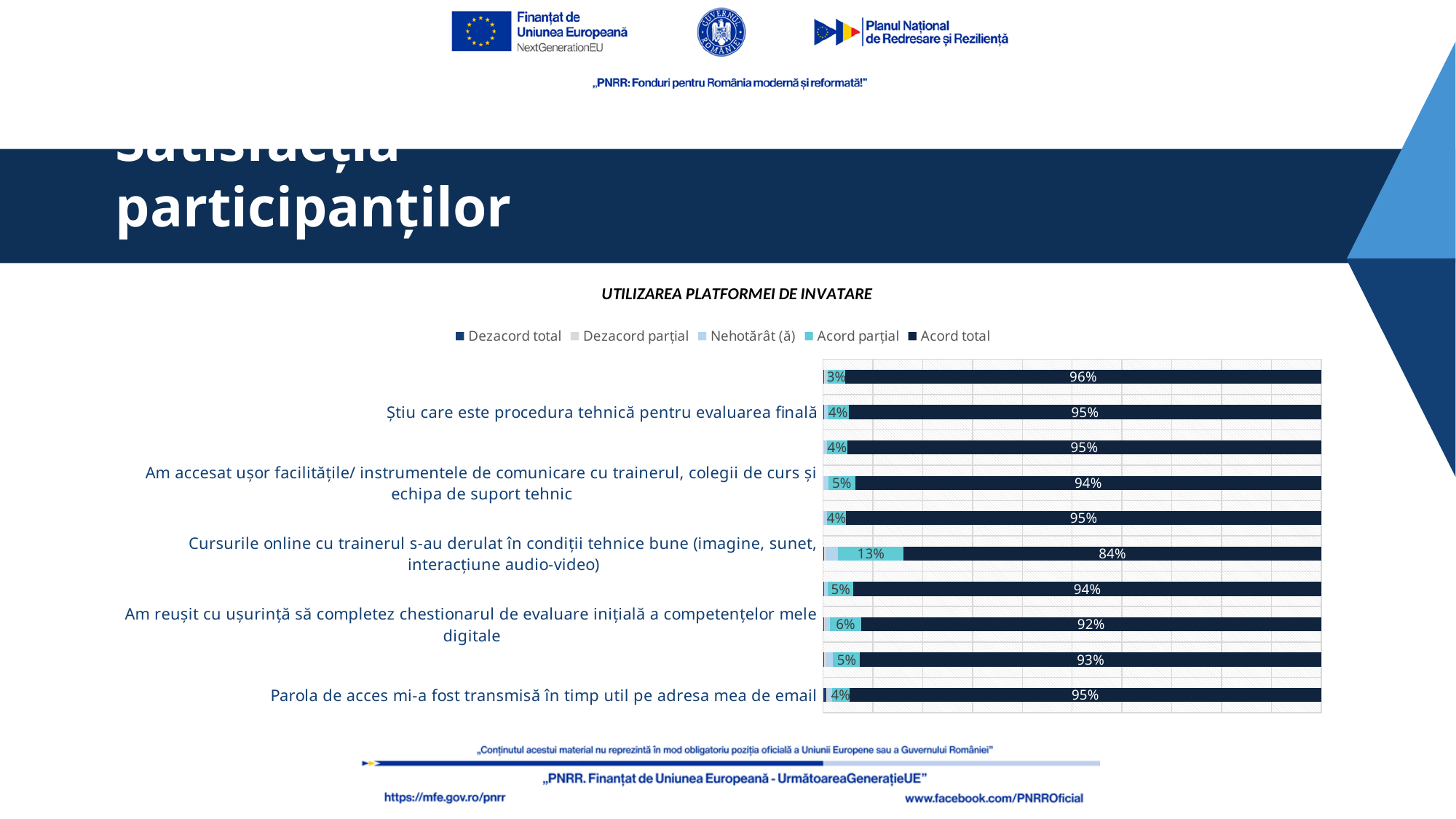
Which labelled statement has the lowest 'Acord total' value? Cursurile online cu trainerul s-au derulat în condiții tehnice bune (imagine, sunet, interacțiune audio-video) Which has the larger 'Acord parțial' value: 'Am accesat ușor facilitățile/ instrumentele de comunicare...' or 'Am reușit cu ușurință să completez chestionarul de evaluare inițială...'? Am reușit cu ușurință să completez chestionarul de evaluare inițială a competențelor mele digitale What is the 'Acord total' value for 'Parola de acces mi-a fost transmisă în timp util pe adresa mea de email'? 95% What is the 'Acord total' value for 'Am accesat ușor facilitățile/ instrumentele de comunicare cu trainerul, colegii de curs și echipa de suport tehnic'? 94% What is the title of the chart? UTILIZAREA PLATFORMEI DE INVATARE What kind of chart is shown on the slide? Stacked horizontal bar chart How many bars are plotted in the chart? 10 What is the difference in 'Acord total' between 'Parola de acces mi-a fost transmisă în timp util pe adresa mea de email' and 'Cursurile online cu trainerul s-au derulat în condiții tehnice bune'? 11 percentage points How many series does the chart legend list? 5 What is the 'Acord parțial' value for 'Cursurile online cu trainerul s-au derulat în condiții tehnice bune (imagine, sunet, interacțiune audio-video)'? 13% What is the 'Acord parțial' value for 'Am reușit cu ușurință să completez chestionarul de evaluare inițială a competențelor mele digitale'? 6% What is the 'Acord total' value for 'Cursurile online cu trainerul s-au derulat în condiții tehnice bune (imagine, sunet, interacțiune audio-video)'? 84%